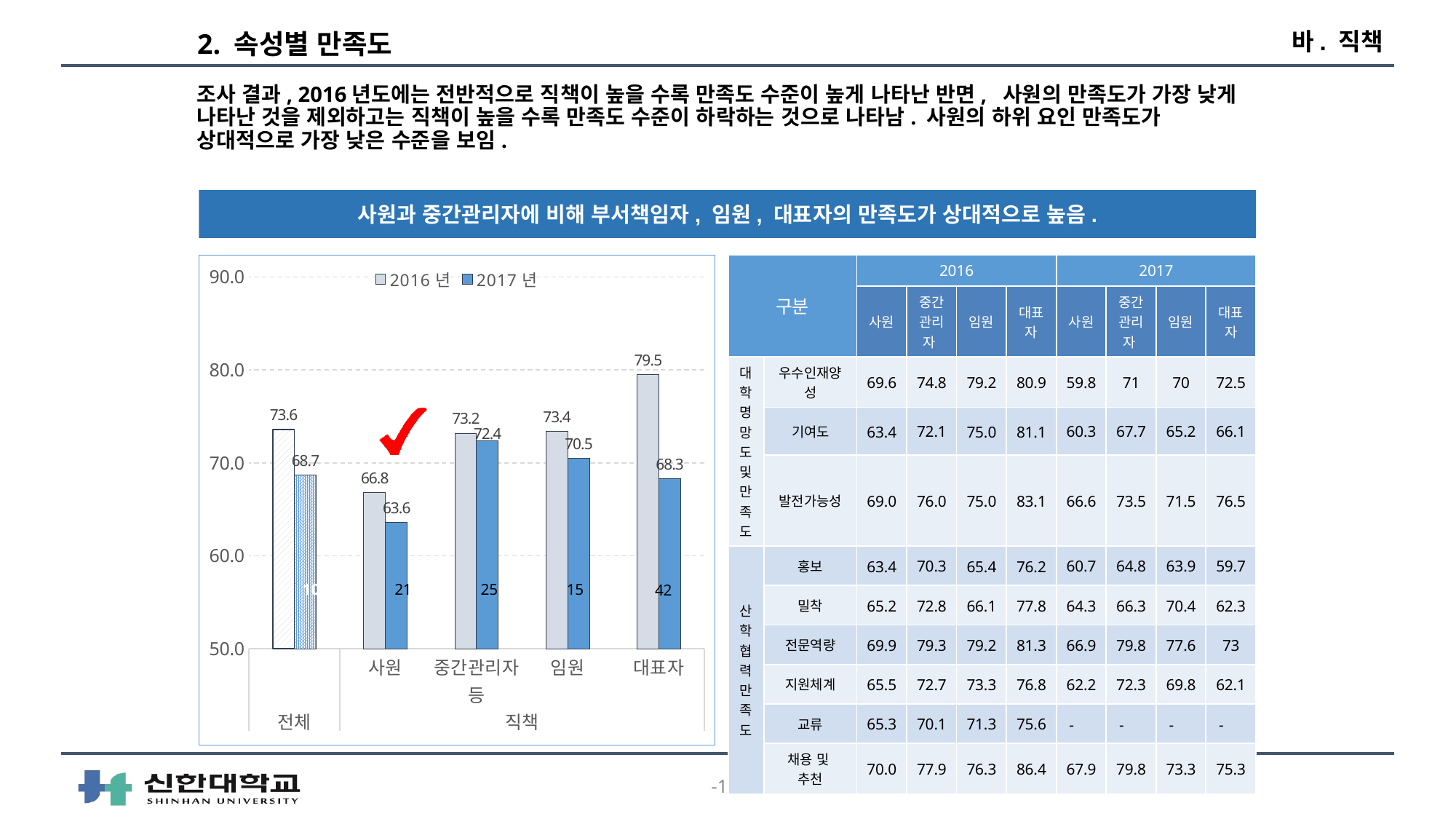
What is the 2016년 value for 대표자 in the chart? 79.5 Which is larger in the chart: the 2017년 value for 임원 or the 2017년 value for 대표자? 임원 What type of chart is shown on the slide? bar chart What is the 2016년 value for 전체 in the chart? 73.6 Which category has the highest 2016년 value in the chart? 대표자 What is the 2017년 value for 중간관리자 등 in the chart? 72.4 What are the two legend entries of the chart? 2016 년, 2017 년 How many series does the chart legend list? 2 Which category has the lowest 2017년 value in the chart? 사원 How many categories are shown on the x axis of the chart? 5 What is the difference between the 2016년 and 2017년 values for 대표자 in the chart? 11.2 What is the 2017년 value for 사원 in the chart? 63.6